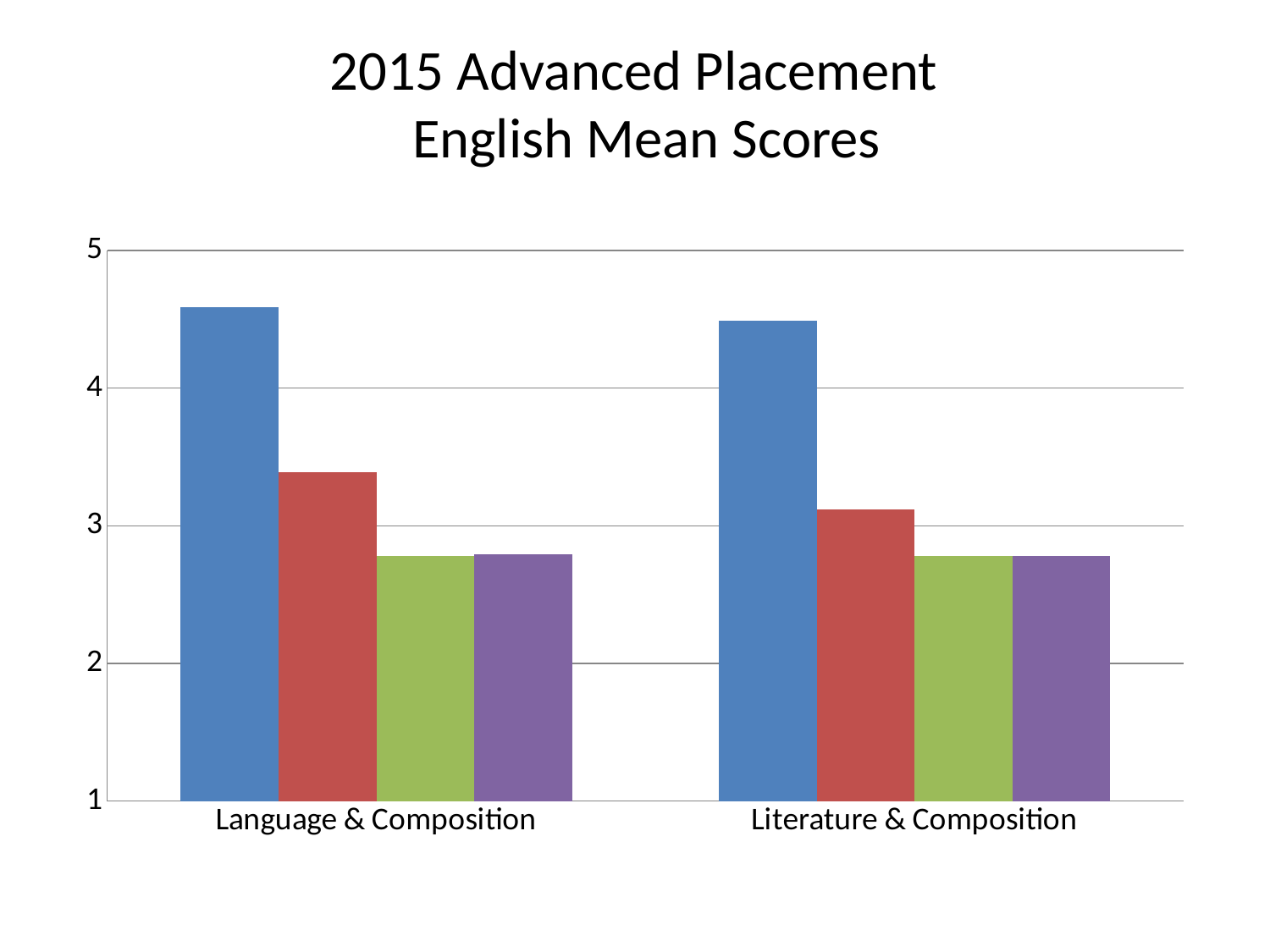
What is the title of the chart? 2015 Advanced Placement English Mean Scores Is the value of the blue bar for Language & Composition greater or less than 4? greater Which coloured bar is the tallest in the Language & Composition category? blue Is the value of the purple bar for Literature & Composition greater or less than 3? less How many bars are plotted for the Language & Composition category? 4 How many categories are shown on the x axis? 2 Which coloured bar is the tallest in the Literature & Composition category? blue What kind of chart is shown on the slide? bar chart Is the value of the red bar for Language & Composition greater or less than 3? greater Which is larger, the red bar for Language & Composition or the red bar for Literature & Composition? Language & Composition